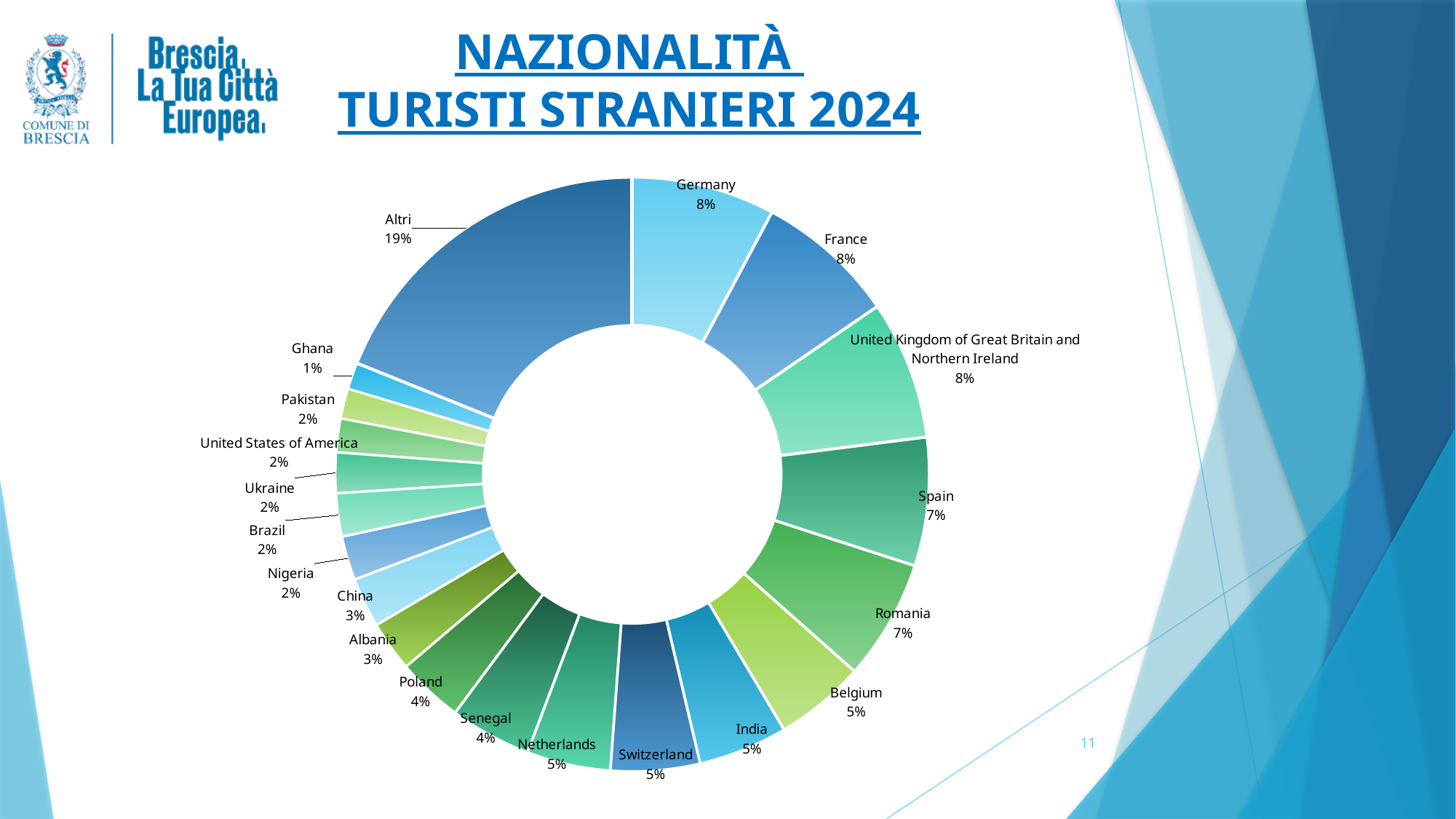
Which has a larger share, Poland or China? Poland What is the difference in percentage points between the Altri slice and the Germany slice? 11 What percentage is shown for Spain? 7% How many slices does the chart have? 20 What is the title of the slide containing the chart? NAZIONALITÀ TURISTI STRANIERI 2024 What share of foreign tourists in 2024 came from Germany? 8% What percentage is shown for Ghana? 1% Which has a larger share, Romania or Belgium? Romania Which slice of the chart is the largest? Altri Which named country has the smallest share in the chart? Ghana What percentage is shown for Senegal? 4% What kind of chart is shown on the slide? Doughnut (pie) chart